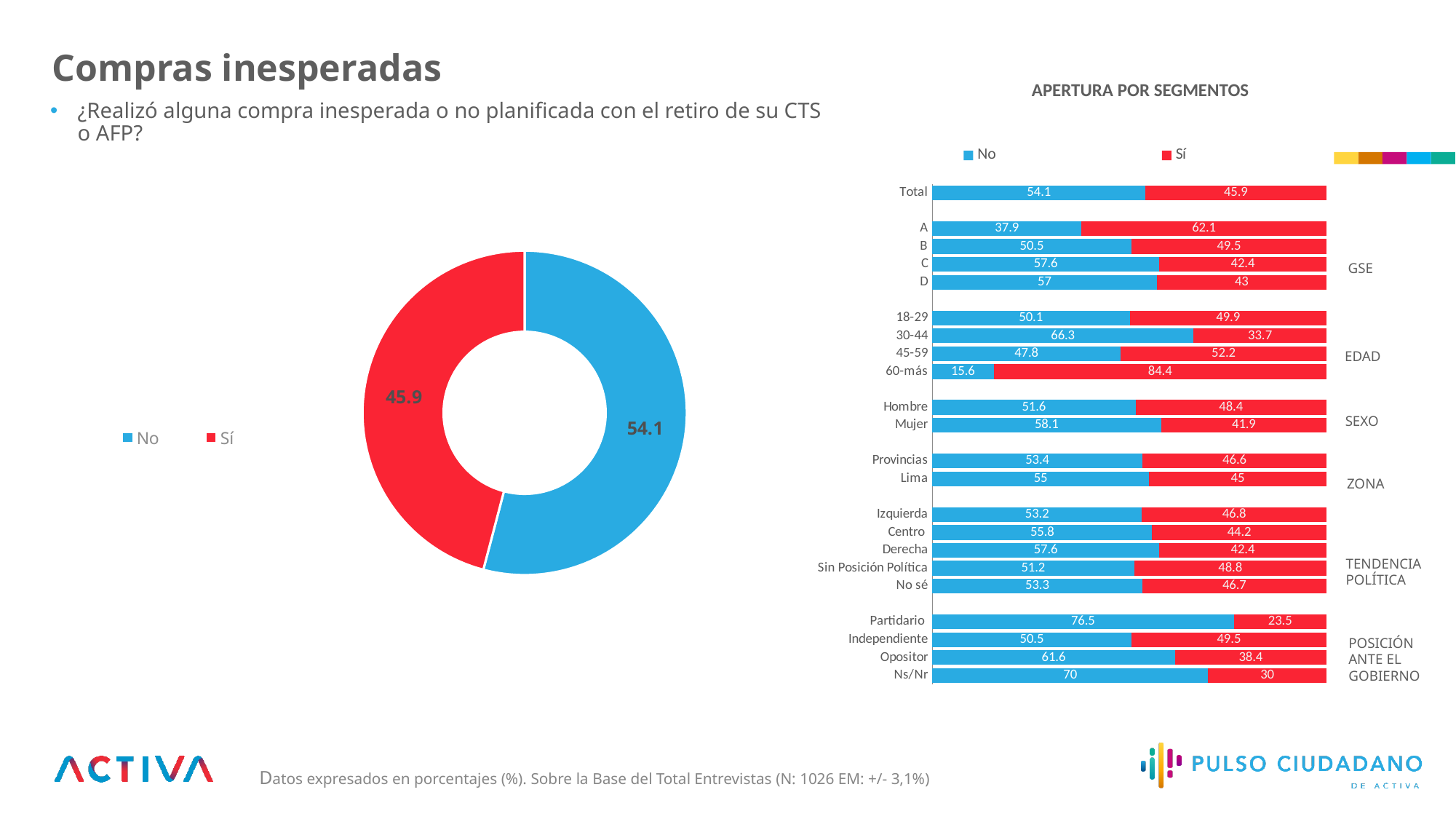
On the "APERTURA POR SEGMENTOS" chart, which segment has the highest "Sí" value? 60-más On the "APERTURA POR SEGMENTOS" chart, which segment has the lowest "Sí" value? Partidario On the donut chart on the left, which slice is larger, "No" or "Sí"? No What kind of chart is the chart on the left of the slide? Pie (donut) chart How many series does the legend of the "APERTURA POR SEGMENTOS" chart list? 2 On the "APERTURA POR SEGMENTOS" chart, what is the difference between the "No" and "Sí" values for the 30-44 segment? 32.6 On the "APERTURA POR SEGMENTOS" chart, what is the "No" value for Partidario? 76.5 On the "APERTURA POR SEGMENTOS" chart, which has a higher "No" value, Hombre or Mujer? Mujer On the donut chart on the left, what percentage answered "No"? 54.1 On the "APERTURA POR SEGMENTOS" chart, what is the "Sí" value for the 60-más segment? 84.4 On the donut chart on the left, what percentage answered "Sí"? 45.9 How many segment bars are shown on the "APERTURA POR SEGMENTOS" chart? 22